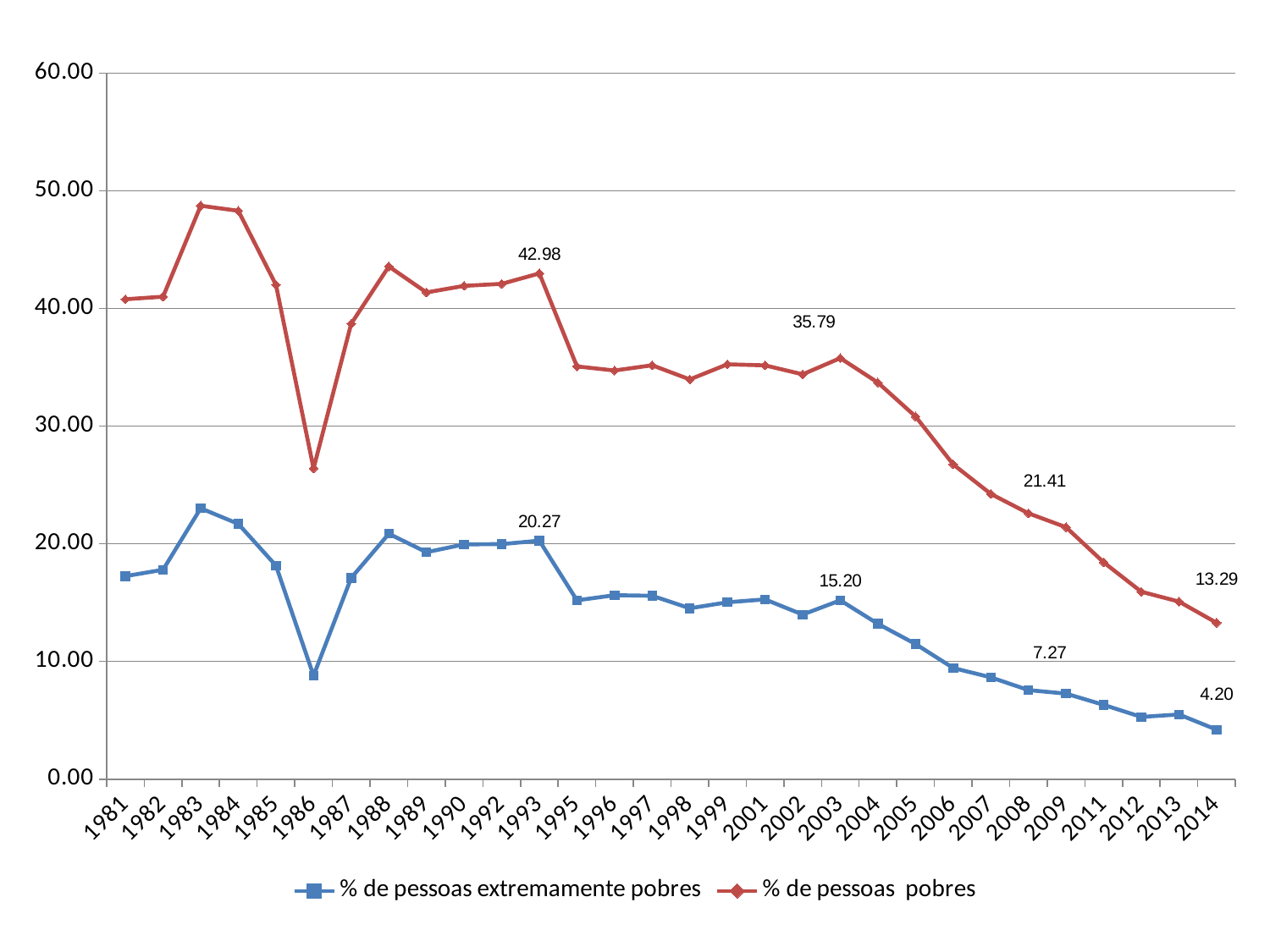
What is the value of "% de pessoas pobres" in 2003? 35.79 In which year is "% de pessoas pobres" at its lowest? 2014 What is the value of "% de pessoas extremamente pobres" in 2014? 4.20 How many years are shown on the x axis? 30 What kind of chart is shown on the slide? line chart What is the difference between "% de pessoas pobres" and "% de pessoas extremamente pobres" in 2014? 9.09 What is the value of "% de pessoas extremamente pobres" in 2009? 7.27 How many series does the legend list? 2 What is the value of "% de pessoas pobres" in 1993? 42.98 Which is larger for "% de pessoas pobres": the value in 2003 or the value in 2009? 2003 Is the value of "% de pessoas extremamente pobres" in 1986 greater or less than 10.00? less Is the value of "% de pessoas pobres" in 1986 greater or less than 30.00? less